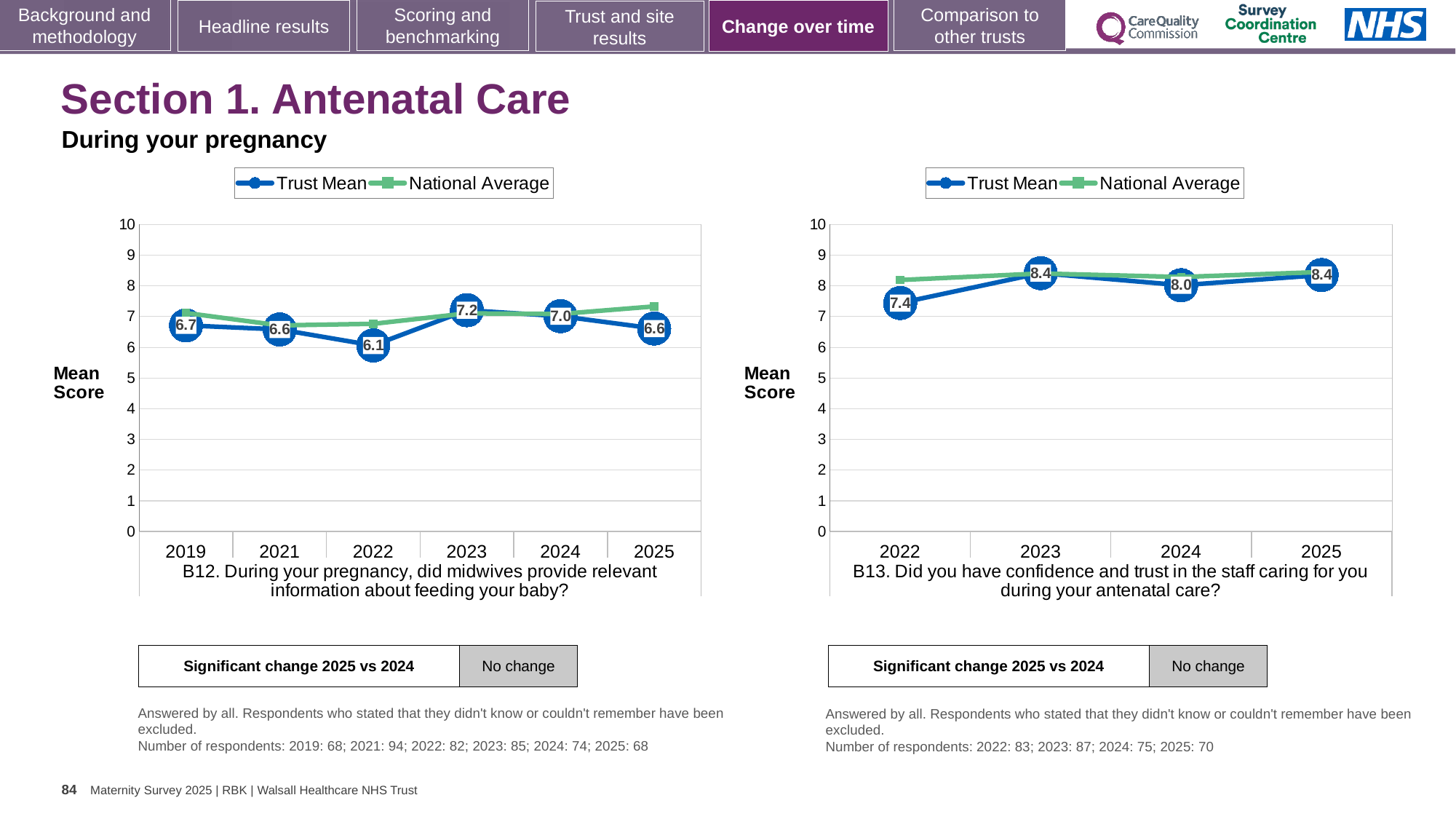
In the B12 chart (left), which year has the highest Trust Mean? 2023 In the B12 chart (left), what is the Trust Mean for 2022? 6.1 What type of chart is the B13 chart (right)? Line chart In the B13 chart (right), what is the Trust Mean for 2024? 8.0 In the B13 chart (right), which year has the lowest Trust Mean? 2022 In the B13 chart (right), what is the Trust Mean for 2022? 7.4 In the B12 chart (left), which year has the lowest Trust Mean? 2022 In the B13 chart (right), how many series does the legend list? 2 In the B13 chart (right), is the Trust Mean for 2023 larger or smaller than the Trust Mean for 2024? larger In the B12 chart (left), how many years are shown on the x axis? 6 In the B12 chart (left), what is the difference between the Trust Mean for 2023 and the Trust Mean for 2022? 1.1 In the B12 chart (left), what is the Trust Mean for 2023? 7.2